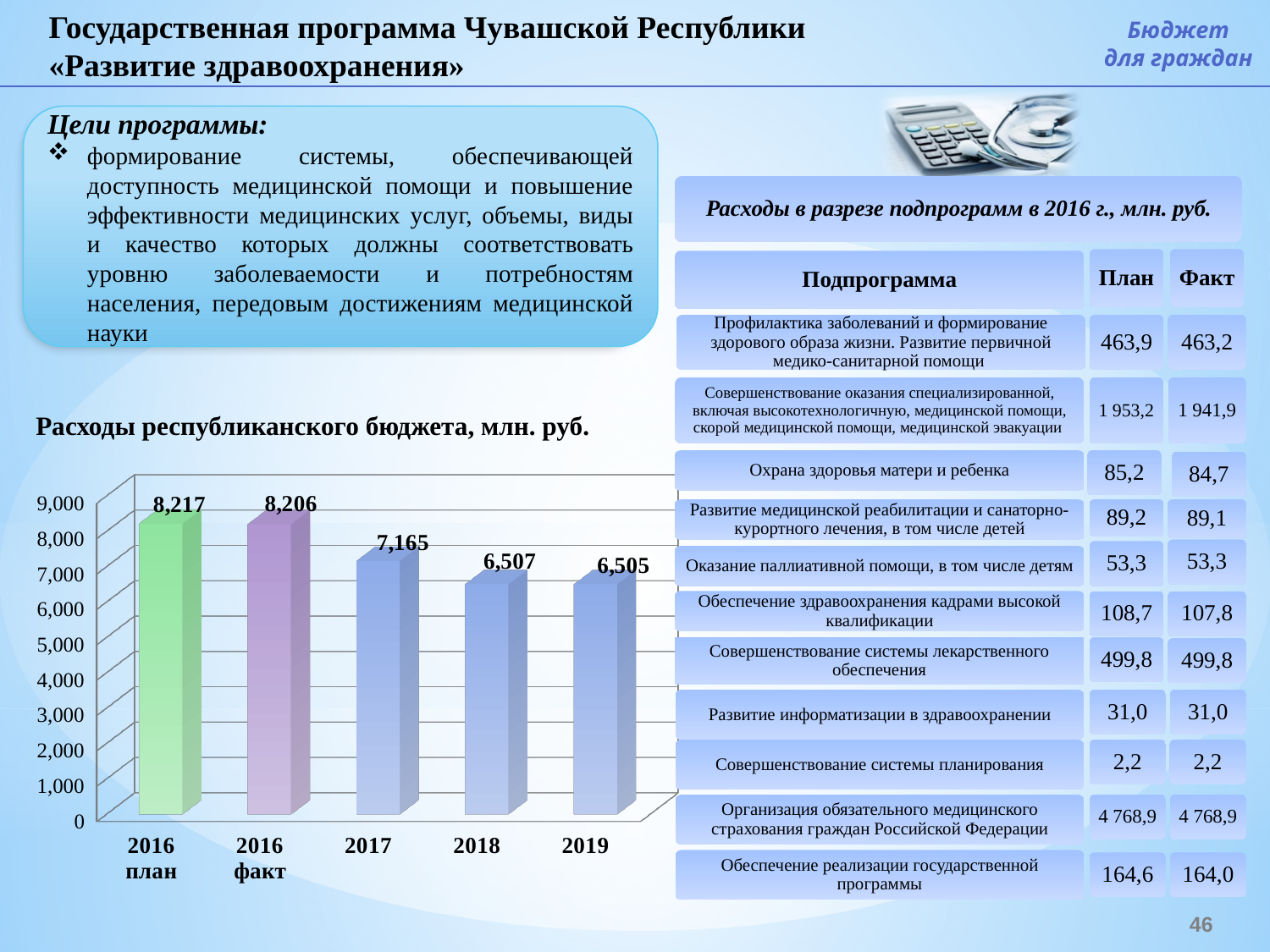
What is the value for 2019 in the chart 'Расходы республиканского бюджета, млн. руб.'? 6,505 What kind of chart is 'Расходы республиканского бюджета, млн. руб.'? bar chart What is the value for 2017 in the chart 'Расходы республиканского бюджета, млн. руб.'? 7,165 Which category has the lowest value in the chart 'Расходы республиканского бюджета, млн. руб.'? 2019 Which category has the highest value in the chart 'Расходы республиканского бюджета, млн. руб.'? 2016 план Is the value for 2018 greater or less than 7,000 in the chart 'Расходы республиканского бюджета, млн. руб.'? less What is the value for 2016 факт in the chart 'Расходы республиканского бюджета, млн. руб.'? 8,206 What is the difference between the 2017 and 2018 values in the chart 'Расходы республиканского бюджета, млн. руб.'? 658 Which is larger in the chart 'Расходы республиканского бюджета, млн. руб.': the value for 2017 or the value for 2018? 2017 What is the value for 2016 план in the chart 'Расходы республиканского бюджета, млн. руб.'? 8,217 What is the difference between the 2016 план and 2016 факт values in the chart 'Расходы республиканского бюджета, млн. руб.'? 11 How many bars are shown in the chart 'Расходы республиканского бюджета, млн. руб.'? 5